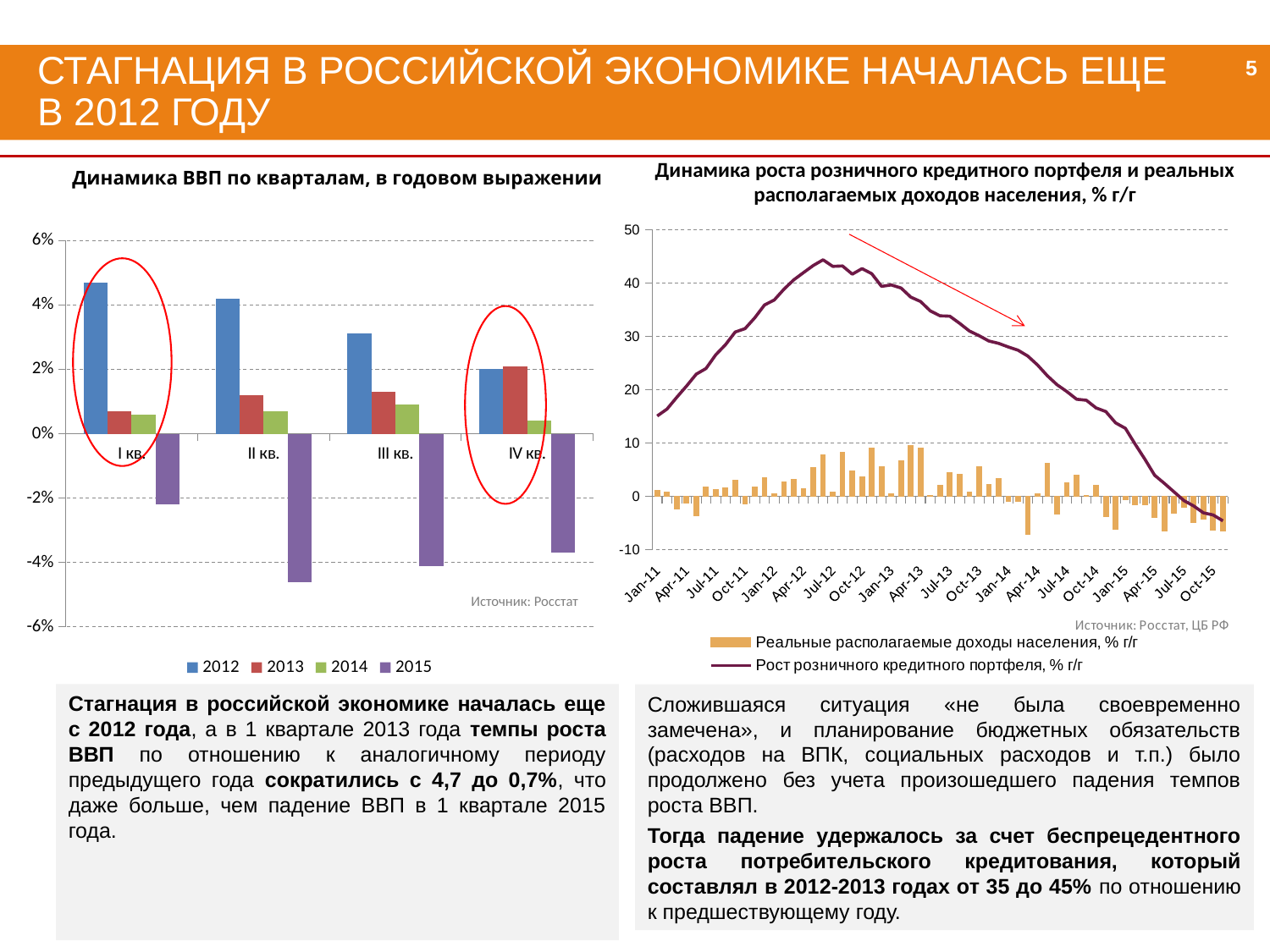
In the right chart, is the value of 'Рост розничного кредитного портфеля, % г/г' at its peak in mid-2012 greater or less than 40? greater In the left chart, 'Динамика ВВП по кварталам', do the values for 2012 rise or fall from I кв. to IV кв.? fall In the left chart, 'Динамика ВВП по кварталам', is the value for 2015 in II кв. greater or less than -4%? less What kind of chart is the left chart, 'Динамика ВВП по кварталам, в годовом выражении'? bar chart In the left chart, 'Динамика ВВП по кварталам', which quarter has the highest value for 2012? I кв. How many series does the legend of the left chart, 'Динамика ВВП по кварталам', list? 4 In the left chart, 'Динамика ВВП по кварталам', which is larger in I кв.: the value for 2012 or the value for 2013? 2012 In the left chart, 'Динамика ВВП по кварталам', which quarter has the lowest value for 2015? II кв. How many series does the legend of the right chart, 'Динамика роста розничного кредитного портфеля и реальных располагаемых доходов населения', list? 2 In the left chart, 'Динамика ВВП по кварталам', is the value for 2012 in I кв. greater or less than 4%? greater How many quarter categories are shown on the x axis of the left chart, 'Динамика ВВП по кварталам'? 4 In the right chart, does the line 'Рост розничного кредитного портфеля, % г/г' rise or fall from Jul-12 to Oct-15? fall